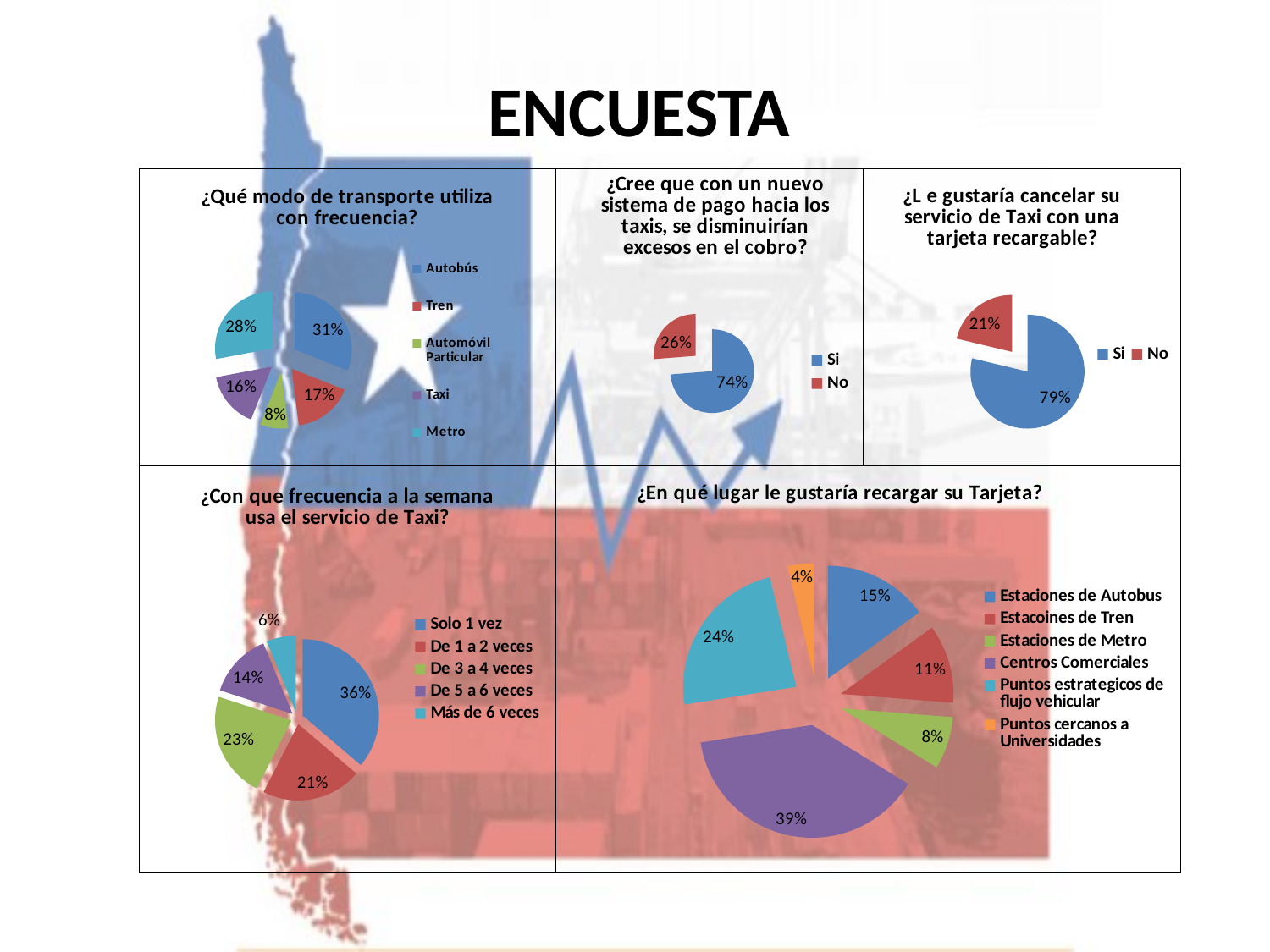
In the chart '¿Qué modo de transporte utiliza con frecuencia?', which mode has the smallest share? Automóvil Particular In the chart '¿Con que frecuencia a la semana usa el servicio de Taxi?', which category has the largest share? Solo 1 vez In the chart '¿Cree que con un nuevo sistema de pago hacia los taxis, se disminuirían excesos en el cobro?', what is the difference between Si and No? 48% In the chart '¿Qué modo de transporte utiliza con frecuencia?', how many categories does the legend list? 5 In the chart '¿En qué lugar le gustaría recargar su Tarjeta?', which is larger: Estaciones de Autobus or Estaciones de Tren? Estaciones de Autobus What kind of chart is used for '¿Le gustaría cancelar su servicio de Taxi con una tarjeta recargable?'? Pie chart In the chart '¿Qué modo de transporte utiliza con frecuencia?', what share is Autobús? 31% In the chart '¿Le gustaría cancelar su servicio de Taxi con una tarjeta recargable?', what share answered No? 21% In the chart '¿En qué lugar le gustaría recargar su Tarjeta?', how many categories does the legend list? 6 In the chart '¿En qué lugar le gustaría recargar su Tarjeta?', which location has the largest share? Centros Comerciales In the chart '¿Cree que con un nuevo sistema de pago hacia los taxis, se disminuirían excesos en el cobro?', what share answered Si? 74% In the chart '¿Con que frecuencia a la semana usa el servicio de Taxi?', what share is 'De 3 a 4 veces'? 23%